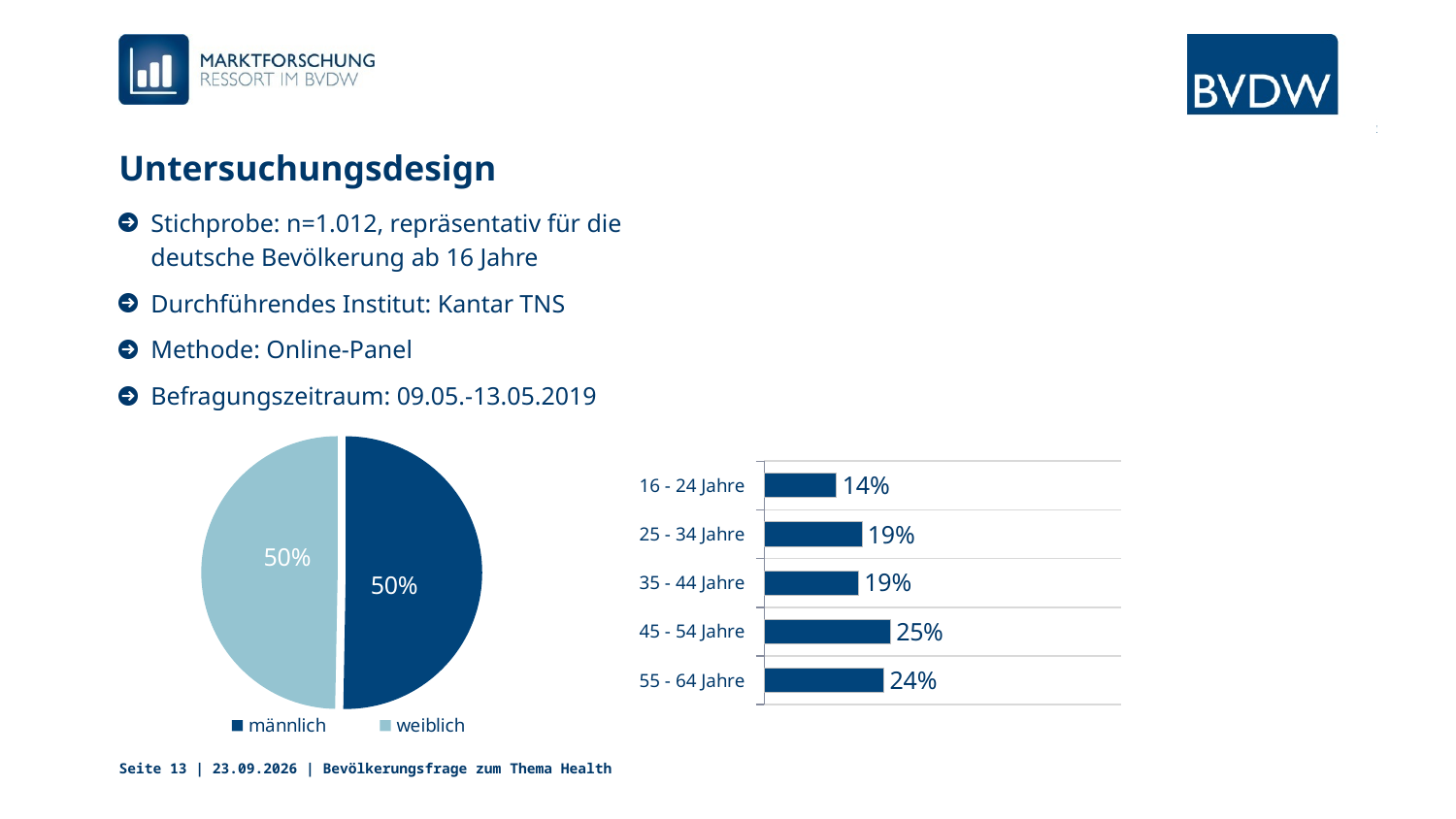
In the bar chart on the right, what is the difference between the values for 45 - 54 Jahre and 16 - 24 Jahre? 11% In the bar chart on the right, which is larger: the value for 25 - 34 Jahre or the value for 55 - 64 Jahre? 55 - 64 Jahre In the bar chart on the right, what is the value for 45 - 54 Jahre? 25% How many entries does the legend of the pie chart on the left list? 2 In the pie chart on the left, what share does männlich have? 50% In the bar chart on the right, what is the value for 55 - 64 Jahre? 24% In the bar chart on the right, what is the value for 16 - 24 Jahre? 14% What kind of chart is the chart on the right of the slide? bar chart What kind of chart is the chart on the left of the slide? pie chart In the bar chart on the right, which age group has the lowest value? 16 - 24 Jahre How many age groups are shown in the bar chart on the right? 5 In the bar chart on the right, which age group has the highest value? 45 - 54 Jahre